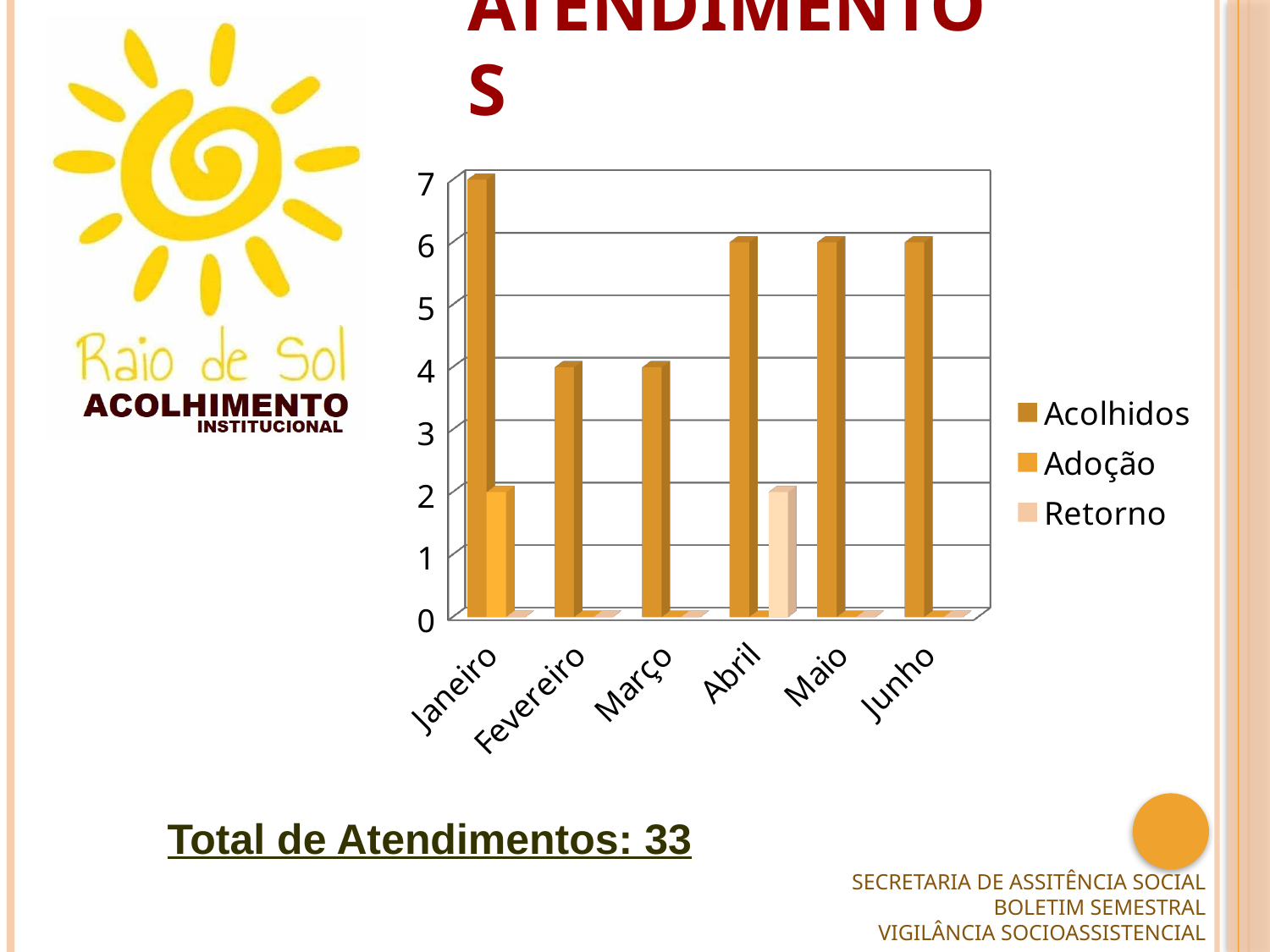
What is the value of Retorno for Abril? 2 How many series does the legend list? 3 What is the difference between the Acolhidos values for Janeiro and Fevereiro? 3 What is the value of Acolhidos for Abril? 6 What is the value of Adoção for Janeiro? 2 Which is larger, the Acolhidos value for Janeiro or for Maio? Janeiro What kind of chart is shown on the slide? bar chart How many months are shown on the x axis? 6 Is the Acolhidos value for Março greater or less than 5? less What is the value of Acolhidos for Janeiro? 7 Which month has the highest value for Acolhidos? Janeiro What is the value of Acolhidos for Fevereiro? 4